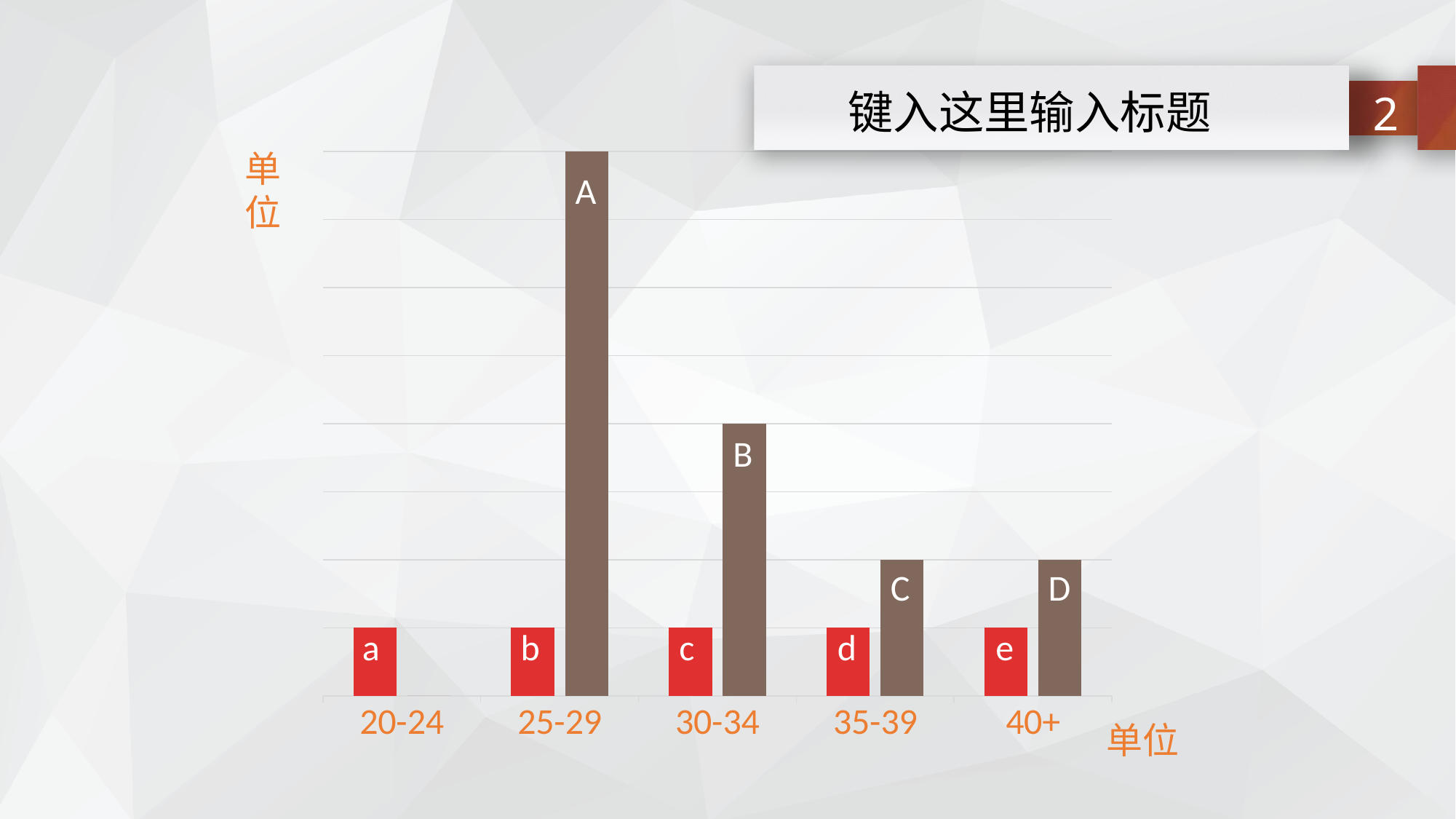
Which category has no brown bar? 20-24 How many brown bars are there in the chart? 4 What label is printed on the brown bar for 25-29? A How many categories are shown on the x axis of the chart? 5 Do the brown bars rise or fall from 25-29 to 35-39? fall What label is printed on the red bar for 35-39? d Which category has the tallest brown bar? 25-29 What label is printed on the brown bar for 30-34? B Which is taller, the brown bar for 25-29 or the brown bar for 30-34? 25-29 Which is taller, the brown bar for 30-34 or the brown bar for 40+? 30-34 What text is shown as the x-axis label at the bottom right of the chart? 单位 What kind of chart is shown on the slide? bar chart